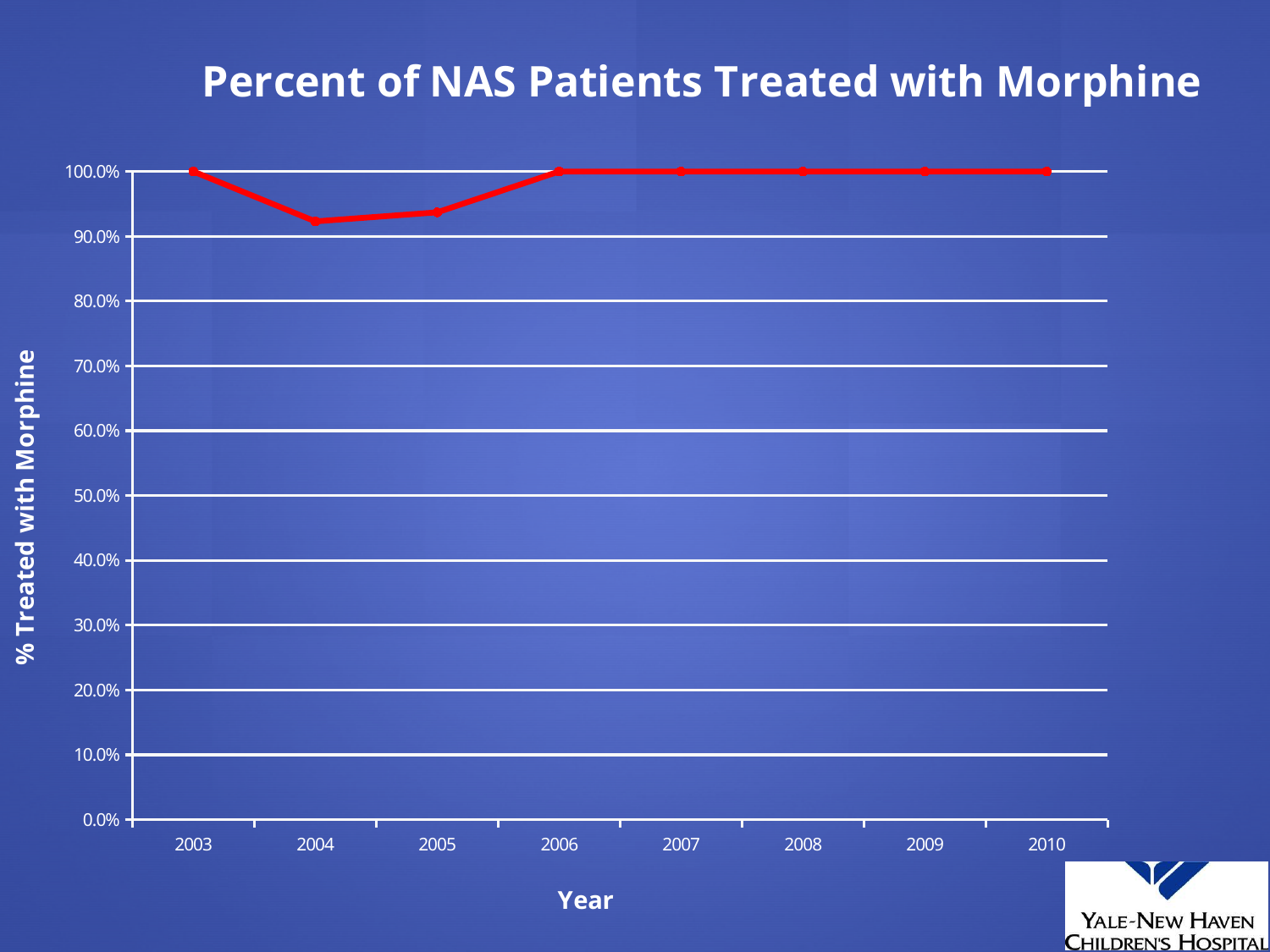
What is the value for 2008? 100.0% Does the value rise or fall from 2003 to 2004? fall What type of chart is shown on the slide? line chart Which year has the lowest value? 2004 Is the value for 2004 greater or less than 90.0%? greater How many years are plotted on the x axis? 8 What is the value for 2003? 100.0% Which is larger, the value for 2003 or the value for 2004? 2003 What is the label of the y axis? % Treated with Morphine Is the value for 2005 greater or less than 100.0%? less What is the chart's title? Percent of NAS Patients Treated with Morphine What is the value for 2010? 100.0%